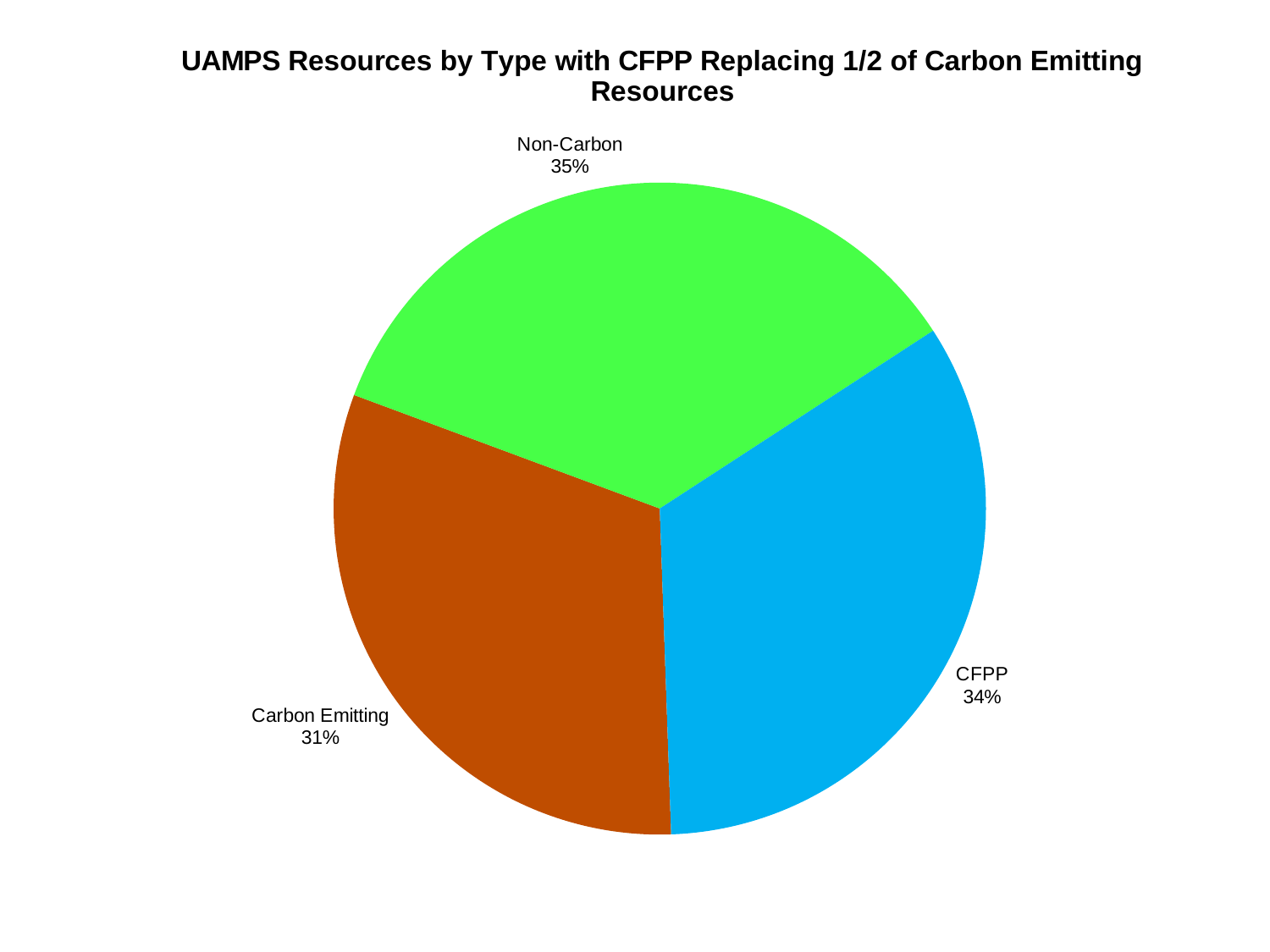
What is the difference in percentage points between the CFPP and Carbon Emitting slices? 3 Which category has the smallest slice of the pie? Carbon Emitting What kind of chart is shown on the slide? Pie chart How many slices does the pie chart have? 3 What share of the pie does CFPP represent? 34% What is the difference in percentage points between the Non-Carbon and Carbon Emitting slices? 4 What colour is the CFPP slice? Blue What share of the pie does Carbon Emitting represent? 31% What is the title of the chart? UAMPS Resources by Type with CFPP Replacing 1/2 of Carbon Emitting Resources What share of the pie does Non-Carbon represent? 35% Which category has the largest slice of the pie? Non-Carbon